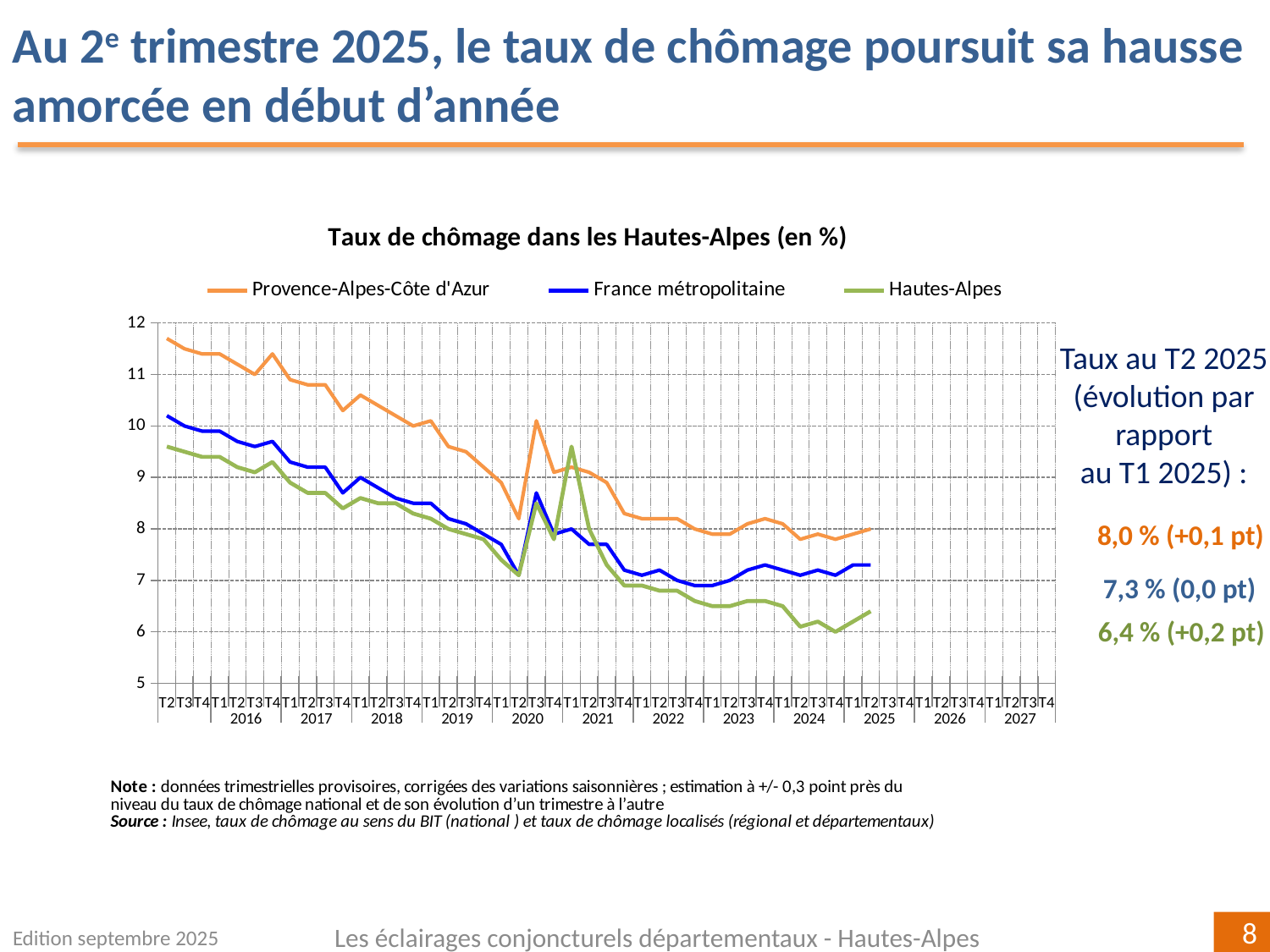
Which series has the lowest value at T2 2025? Hautes-Alpes What is the title of the chart? Taux de chômage dans les Hautes-Alpes (en %) Overall, does the Provence-Alpes-Côte d'Azur line rise or fall between 2015 and 2025? fall By how much did the Hautes-Alpes rate change between T1 2025 and T2 2025? +0,2 pt What is the difference between the Provence-Alpes-Côte d'Azur rate and the Hautes-Alpes rate at T2 2025? 1,6 pt What is the unemployment rate for France métropolitaine at T2 2025? 7,3 % Which series has the highest value at T2 2025? Provence-Alpes-Côte d'Azur What is the unemployment rate for Provence-Alpes-Côte d'Azur at T2 2025? 8,0 % Is the value for Provence-Alpes-Côte d'Azur at the start of the series (T2 2015) greater or less than 11? greater What kind of chart is shown on the slide? line chart How many series does the legend list? 3 What is the unemployment rate for Hautes-Alpes at T2 2025? 6,4 %